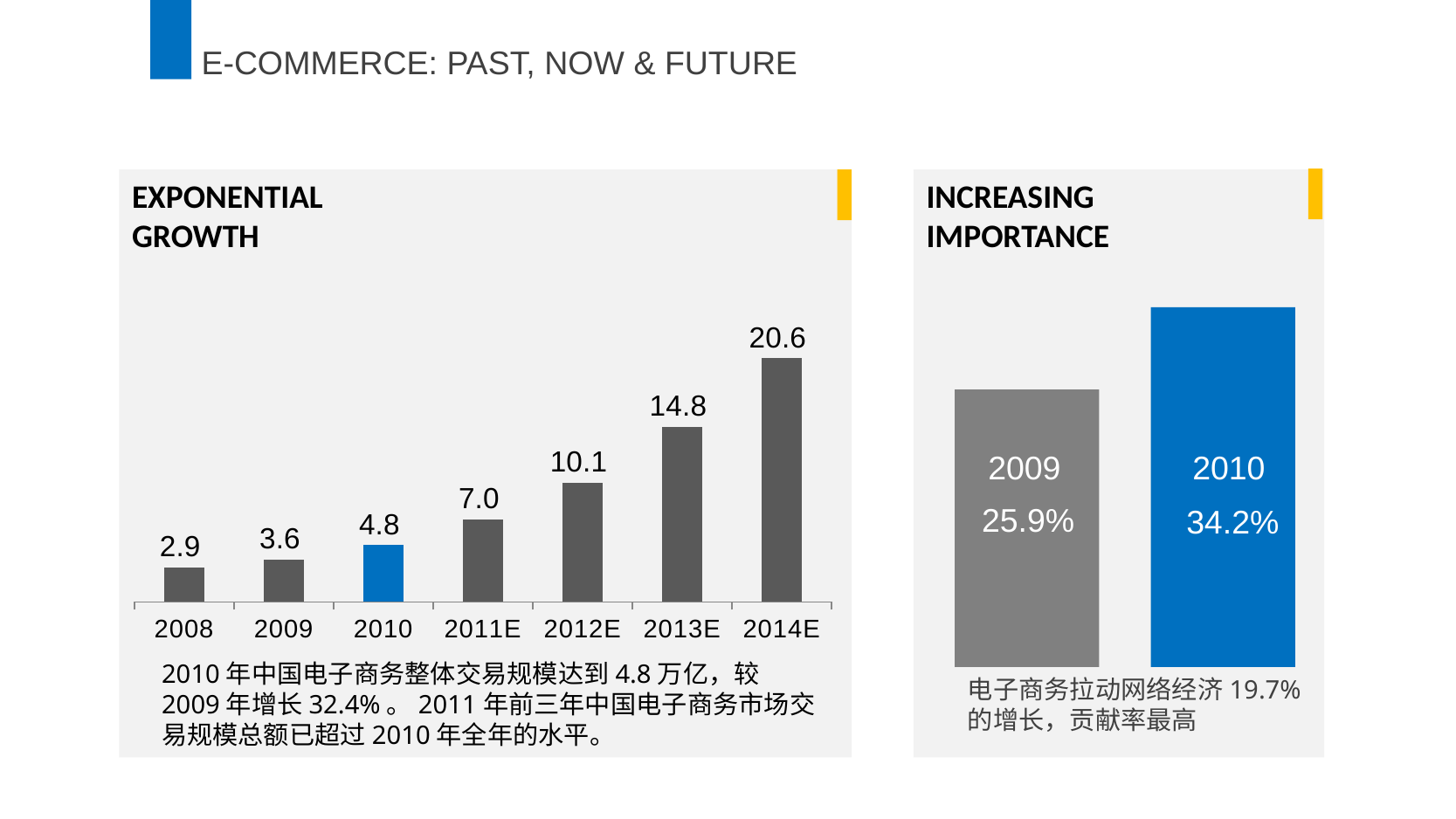
In the 'Exponential Growth' chart, which year has the highest value? 2014E In the 'Exponential Growth' chart, which year has the lowest value? 2008 In the 'Exponential Growth' chart, what is the value for 2010? 4.8 In the 'Increasing Importance' chart, what is the value for 2010? 34.2% In the 'Increasing Importance' chart, what is the value for 2009? 25.9% In the 'Exponential Growth' chart, what is the value for 2014E? 20.6 What kind of chart is the 'Exponential Growth' chart? bar chart In the 'Increasing Importance' chart, what is the difference between the 2010 and 2009 values? 8.3% In the 'Exponential Growth' chart, how many years are shown on the x axis? 7 In the 'Exponential Growth' chart, what is the difference between the values for 2013E and 2012E? 4.7 In the 'Exponential Growth' chart, do the values rise or fall from 2008 to 2014E? rise In the 'Exponential Growth' chart, which bar is coloured blue rather than grey? 2010